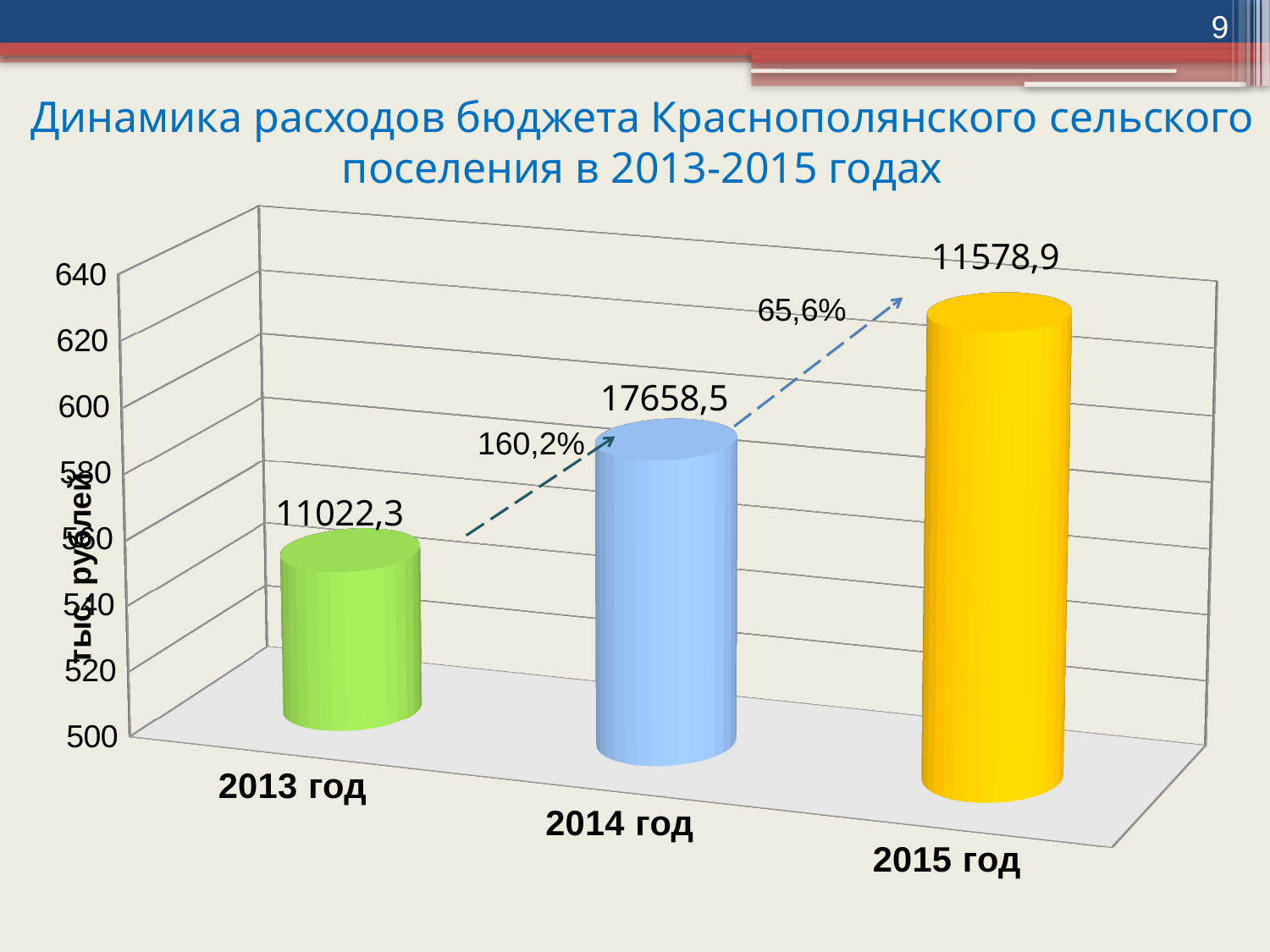
Which has the larger labelled value, 2013 год or 2014 год? 2014 год What is the difference between the labelled values for 2014 год and 2015 год? 6079,6 What value is labelled on the bar for 2014 год? 17658,5 What value is labelled on the bar for 2015 год? 11578,9 What kind of chart is shown on the slide? Bar chart What percentage is written on the arrow between 2013 год and 2014 год? 160,2% Which has the larger labelled value, 2013 год or 2015 год? 2015 год What value is labelled on the bar for 2013 год? 11022,3 What is the difference between the labelled values for 2014 год and 2013 год? 6636,2 How many years (categories) are shown on the chart? 3 What is the title of the chart on the slide? Динамика расходов бюджета Краснополянского сельского поселения в 2013-2015 годах